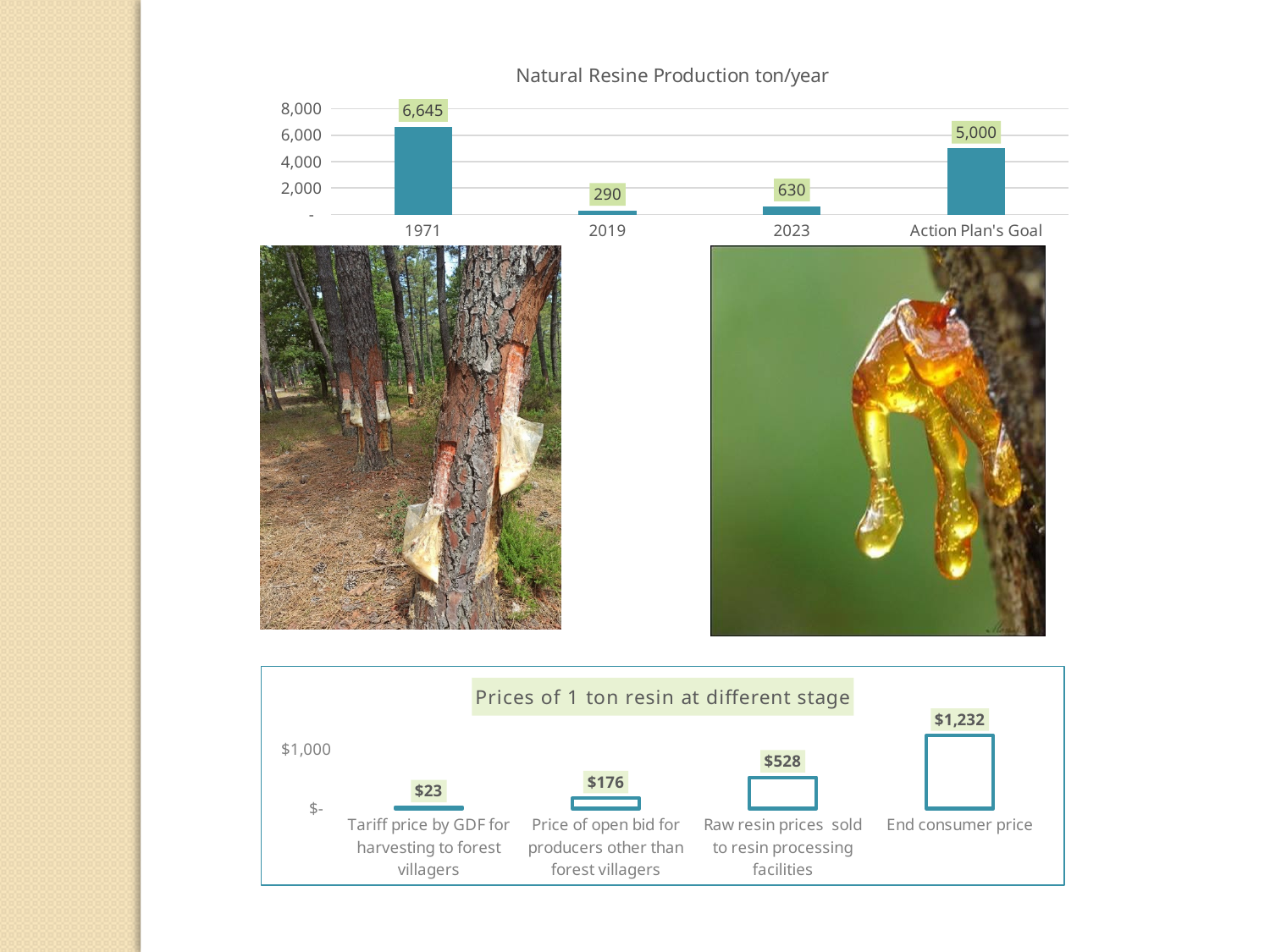
In the 'Natural Resine Production ton/year' chart, how many categories are shown on the x axis? 4 What kind of chart is the 'Prices of 1 ton resin at different stage' chart? bar chart In the 'Natural Resine Production ton/year' chart, what is the value for 2019? 290 In the 'Natural Resine Production ton/year' chart, what is the difference between the 2023 value and the 2019 value? 340 In the 'Natural Resine Production ton/year' chart, which category has the lowest value? 2019 In the 'Natural Resine Production ton/year' chart, what is the value for 1971? 6,645 In the 'Prices of 1 ton resin at different stage' chart, do the values rise or fall from left to right along the x axis? rise In the 'Prices of 1 ton resin at different stage' chart, what is the difference between the raw resin price sold to resin processing facilities and the tariff price by GDF for harvesting to forest villagers? $505 In the 'Natural Resine Production ton/year' chart, which category has the highest value? 1971 In the 'Prices of 1 ton resin at different stage' chart, what is the price of open bid for producers other than forest villagers? $176 In the 'Natural Resine Production ton/year' chart, what is the value for Action Plan's Goal? 5,000 In the 'Prices of 1 ton resin at different stage' chart, what is the End consumer price? $1,232